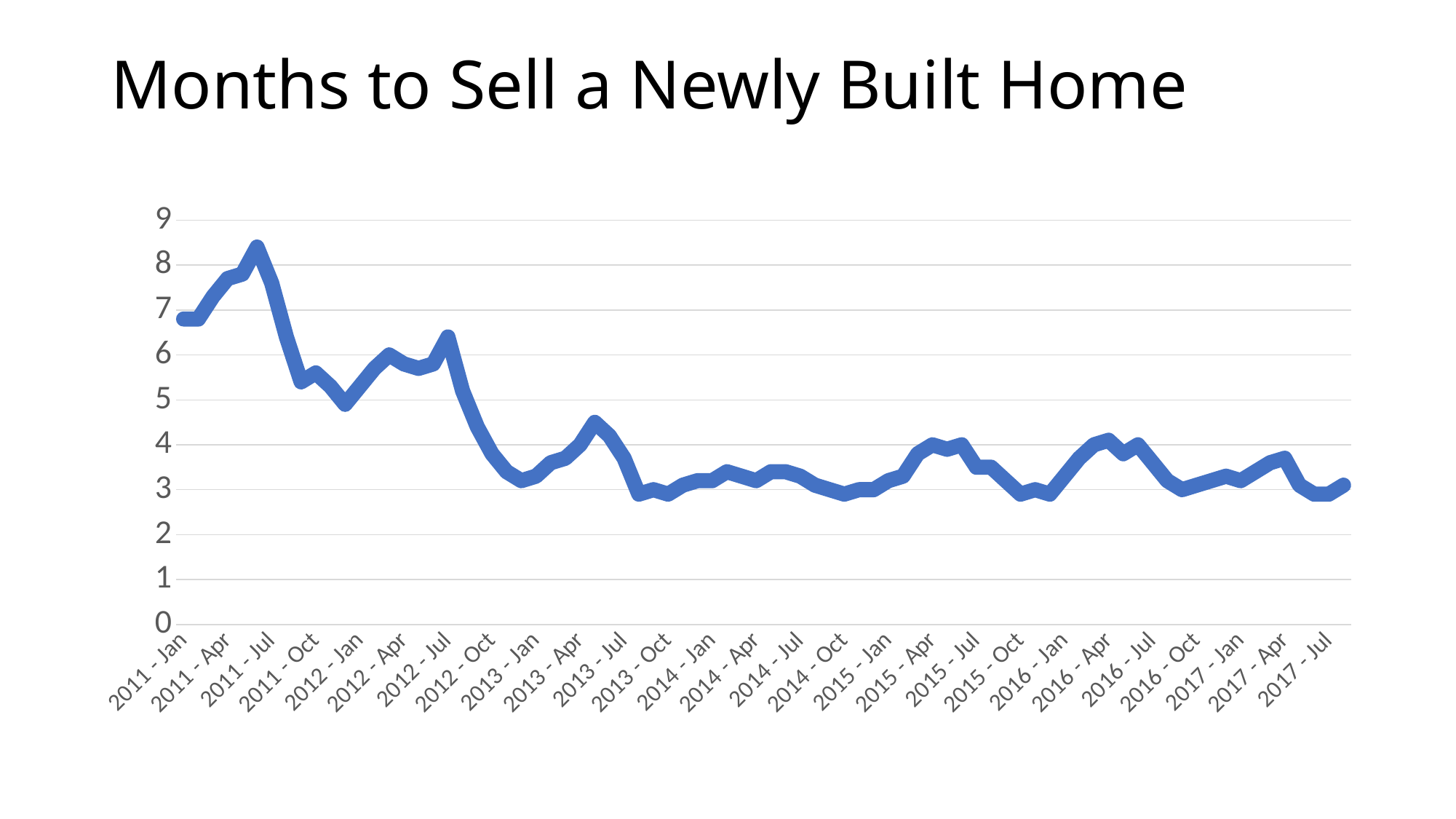
Which is larger, the value for 2012 - Jul or the value for 2013 - Jul? 2012 - Jul Is the value for 2011 - Jul greater or less than 8? less What is the title of the chart? Months to Sell a Newly Built Home What kind of chart is shown on the slide? line chart What is the highest value shown on the vertical axis? 9 Is the value for 2011 - Oct greater or less than 5? greater Is the value for 2014 - Jan greater or less than 4? less Overall, do the values rise or fall from 2011 - Jan to 2017 - Jul? fall Which is larger, the value for 2011 - Jul or the value for 2017 - Jul? 2011 - Jul